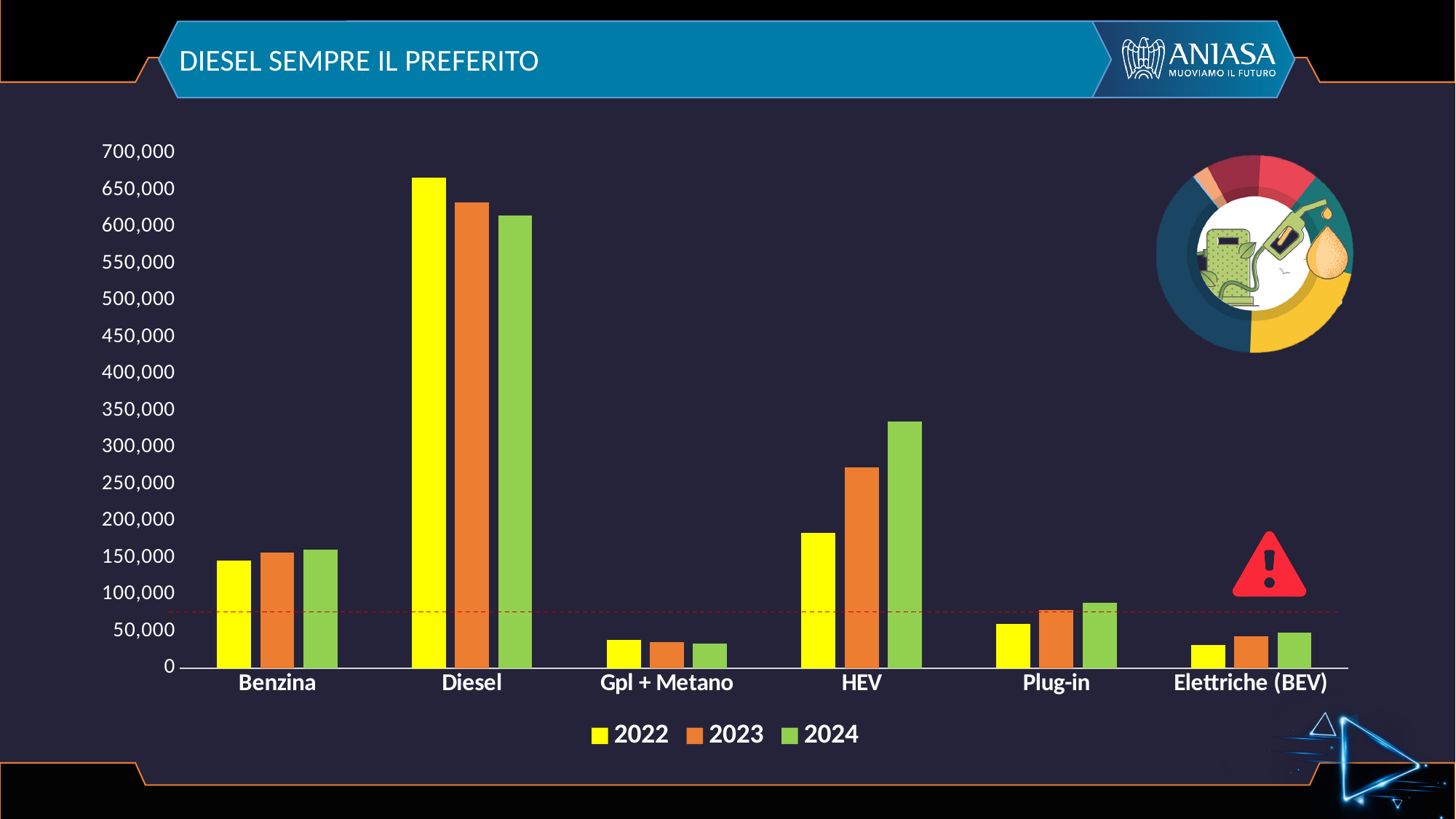
Which category has the lowest value for 2024? Gpl + Metano Do the HEV values rise or fall from 2022 to 2024? rise Do the Diesel values rise or fall from 2022 to 2024? fall Is the value for Plug-in in 2024 greater or less than 100,000? less How many series does the legend list? 3 Is the value for Diesel in 2022 greater or less than 600,000? greater Which is larger in 2024: HEV or Benzina? HEV How many fuel categories are shown on the x axis? 6 Which category has the highest value for 2024? Diesel What is the title of the slide? DIESEL SEMPRE IL PREFERITO Is the value for HEV in 2024 greater or less than 300,000? greater What kind of chart is shown on the slide? bar chart